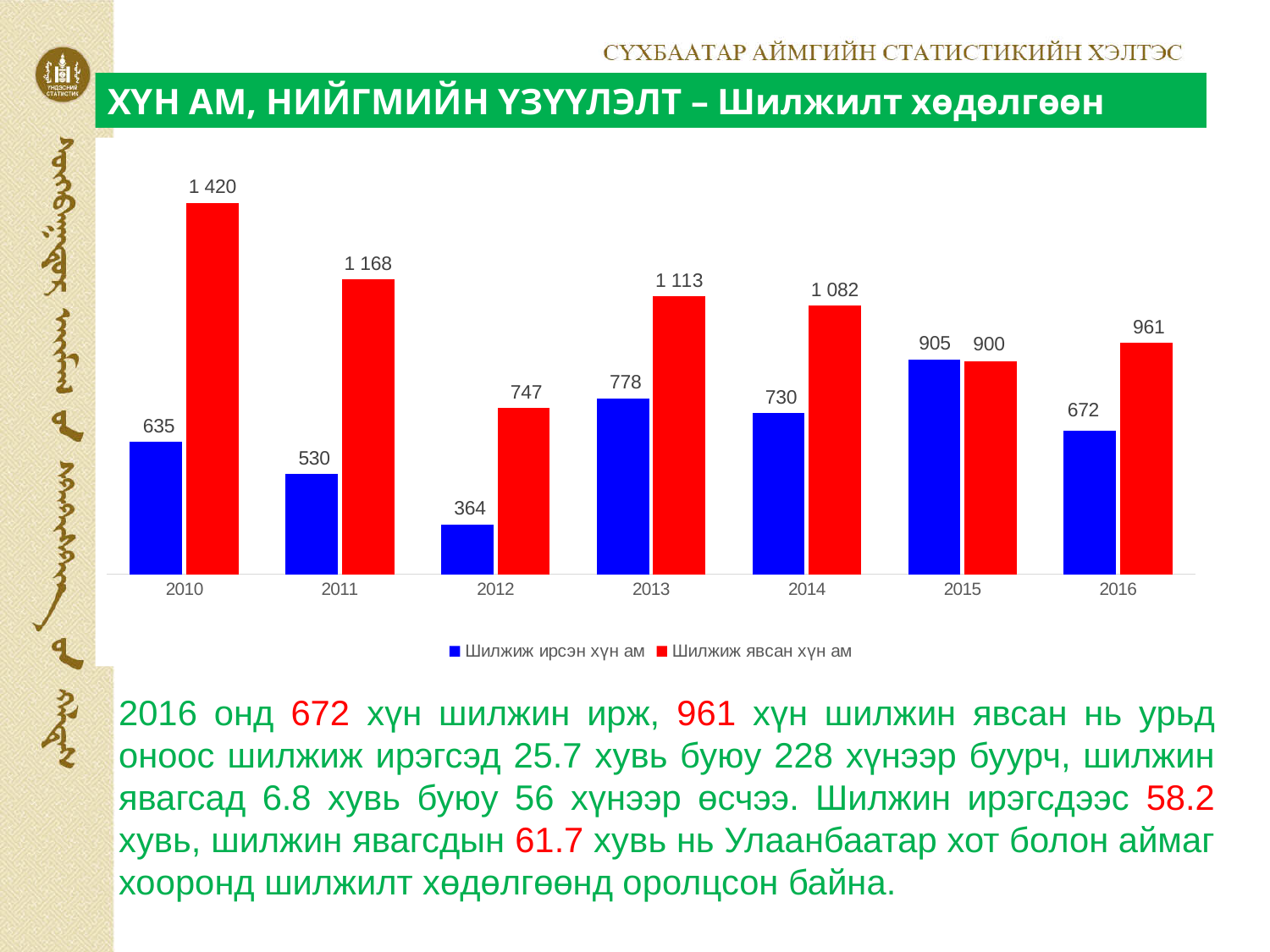
How many years are shown on the x axis of the chart? 7 Which year has the highest value for Шилжиж ирсэн хүн ам? 2015 What is the value of Шилжиж явсан хүн ам for 2016? 961 Which year has the lowest value for Шилжиж ирсэн хүн ам? 2012 What is the difference between Шилжиж явсан хүн ам and Шилжиж ирсэн хүн ам in 2016? 289 What is the value of Шилжиж ирсэн хүн ам for 2013? 778 In 2014, which is larger: Шилжиж ирсэн хүн ам or Шилжиж явсан хүн ам? Шилжиж явсан хүн ам What kind of chart is shown on the slide? Bar chart What is the difference between Шилжиж явсан хүн ам in 2010 and in 2011? 252 What is the value of Шилжиж явсан хүн ам for 2010? 1 420 How many series does the chart legend list? 2 Which year has the highest value for Шилжиж явсан хүн ам? 2010